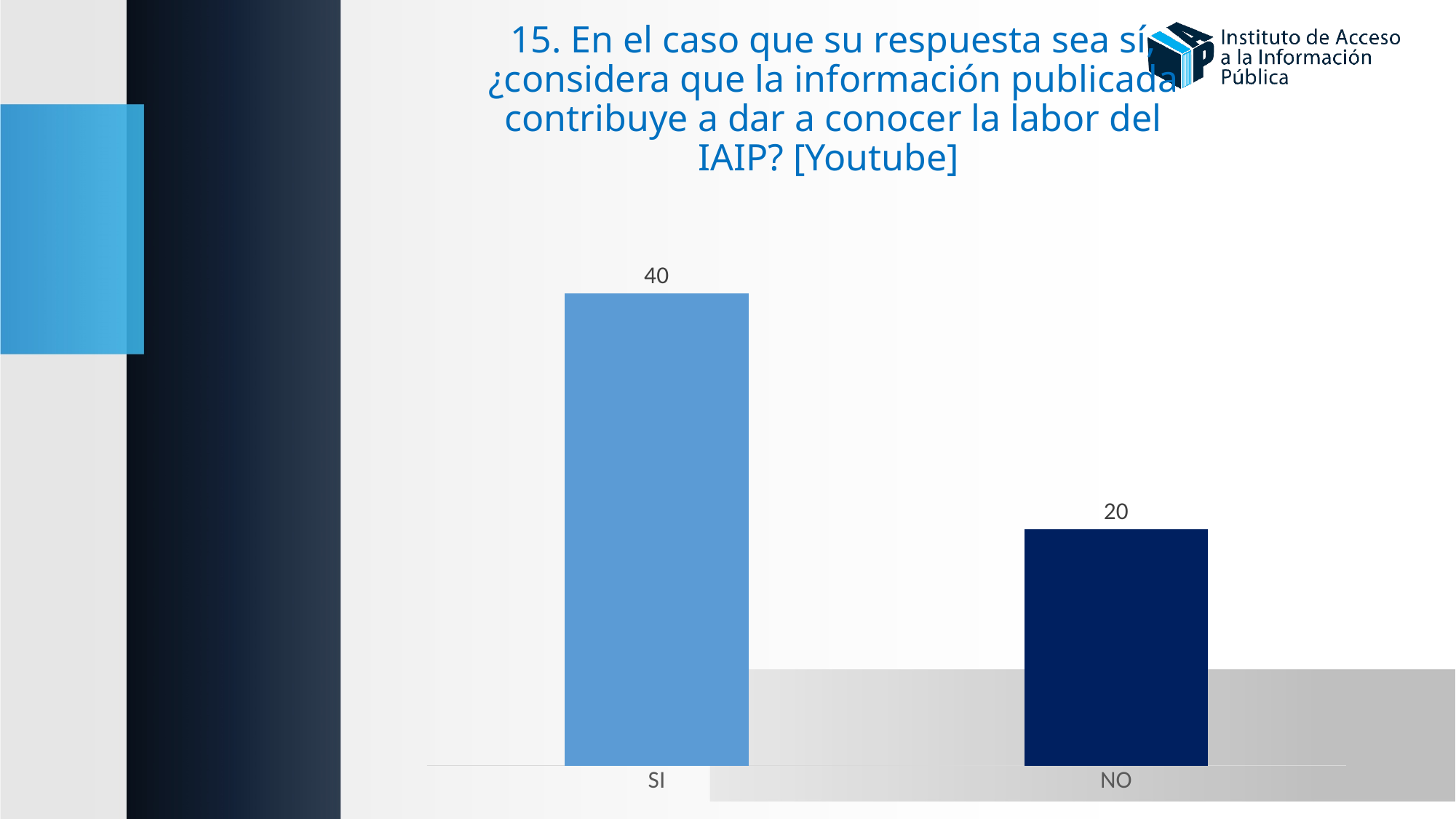
Which platform is named in brackets in the chart title? Youtube What is the difference between the values for SI and NO? 20 Which category has the lowest value? NO Which category has the highest value? SI Which is larger, the value for SI or the value for NO? SI What is the value for NO? 20 What is the value for SI? 40 What colour is the bar for NO? Dark blue What is the total of the values for SI and NO? 60 How many categories are shown in the chart? 2 What kind of chart is shown on the slide? Bar chart